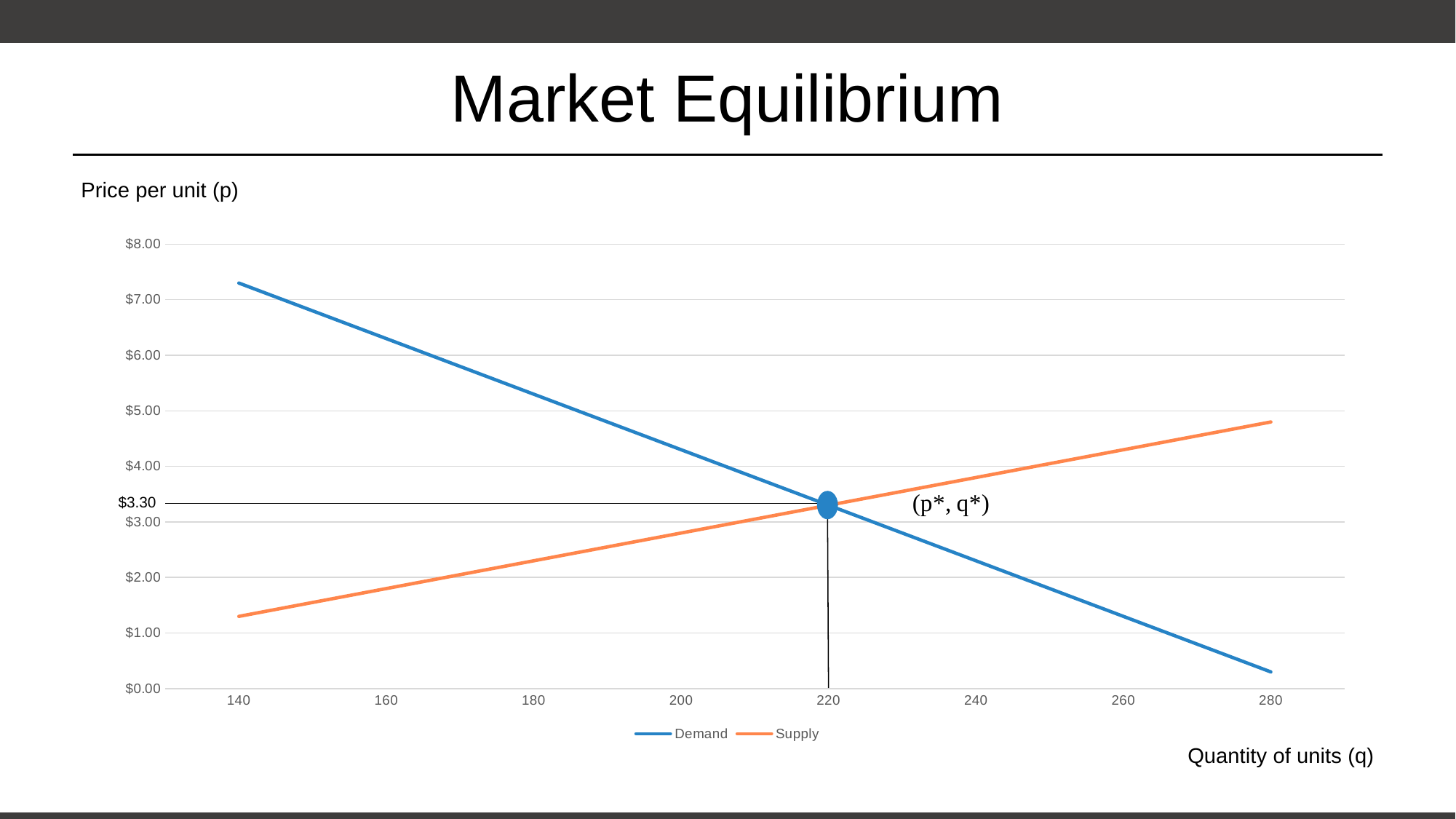
At quantity 260, which line is higher, Demand or Supply? Supply At quantity 160, which line is higher, Demand or Supply? Demand What kind of chart is shown on the slide? line chart Does the Supply line rise or fall as quantity increases along the x axis? rise Is the Supply value at quantity 280 greater or less than $5.00? less At what quantity do the Demand and Supply lines intersect? 220 Is the Demand value at quantity 140 greater or less than $7.00? greater What are the two series named in the legend? Demand and Supply What price is marked at the point where the Demand and Supply lines intersect? $3.30 What is the label of the vertical axis? Price per unit (p) How many series does the legend list? 2 Does the Demand line rise or fall as quantity increases along the x axis? fall